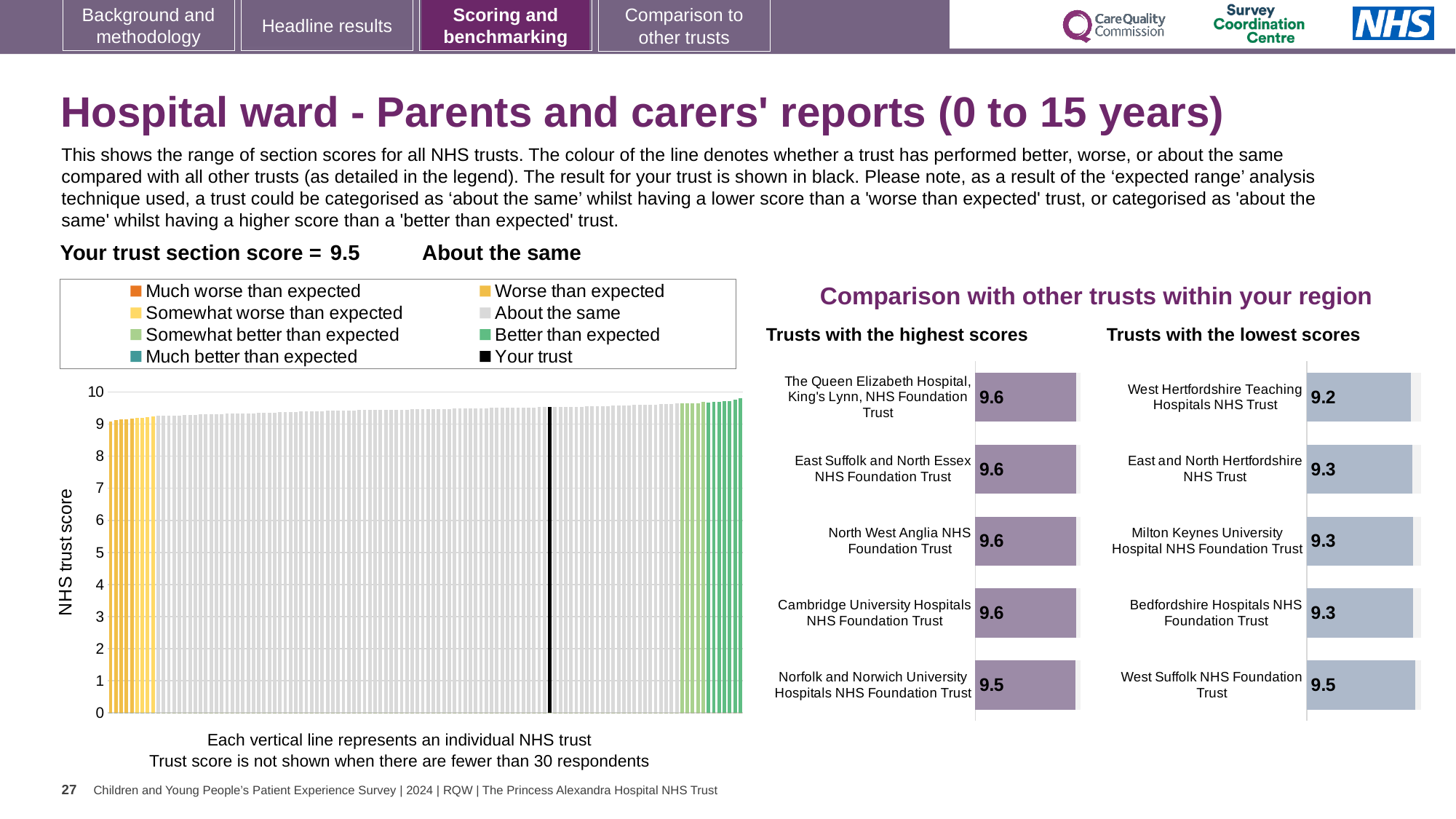
In the 'Trusts with the lowest scores' chart, what is the score for West Hertfordshire Teaching Hospitals NHS Trust? 9.2 In the 'Trusts with the highest scores' chart, which trust has the lowest score? Norfolk and Norwich University Hospitals NHS Foundation Trust In the 'Trusts with the highest scores' chart, what is the score for Norfolk and Norwich University Hospitals NHS Foundation Trust? 9.5 How many entries does the legend above the large chart on the left list? 8 In the 'Trusts with the lowest scores' chart, which has the larger score: Bedfordshire Hospitals NHS Foundation Trust or West Suffolk NHS Foundation Trust? West Suffolk NHS Foundation Trust On the large chart on the left, what is the highest value shown on the y axis? 10 What kind of chart is the large chart on the left with the y axis labelled 'NHS trust score'? bar chart On the large chart on the left, what is the section score for your trust? 9.5 In the 'Trusts with the lowest scores' chart, what is the difference between the scores of West Suffolk NHS Foundation Trust and West Hertfordshire Teaching Hospitals NHS Trust? 0.3 In the 'Trusts with the lowest scores' chart, which trust has the highest score? West Suffolk NHS Foundation Trust How many trusts are shown in the 'Trusts with the highest scores' chart? 5 In the 'Trusts with the lowest scores' chart, which trust has the lowest score? West Hertfordshire Teaching Hospitals NHS Trust